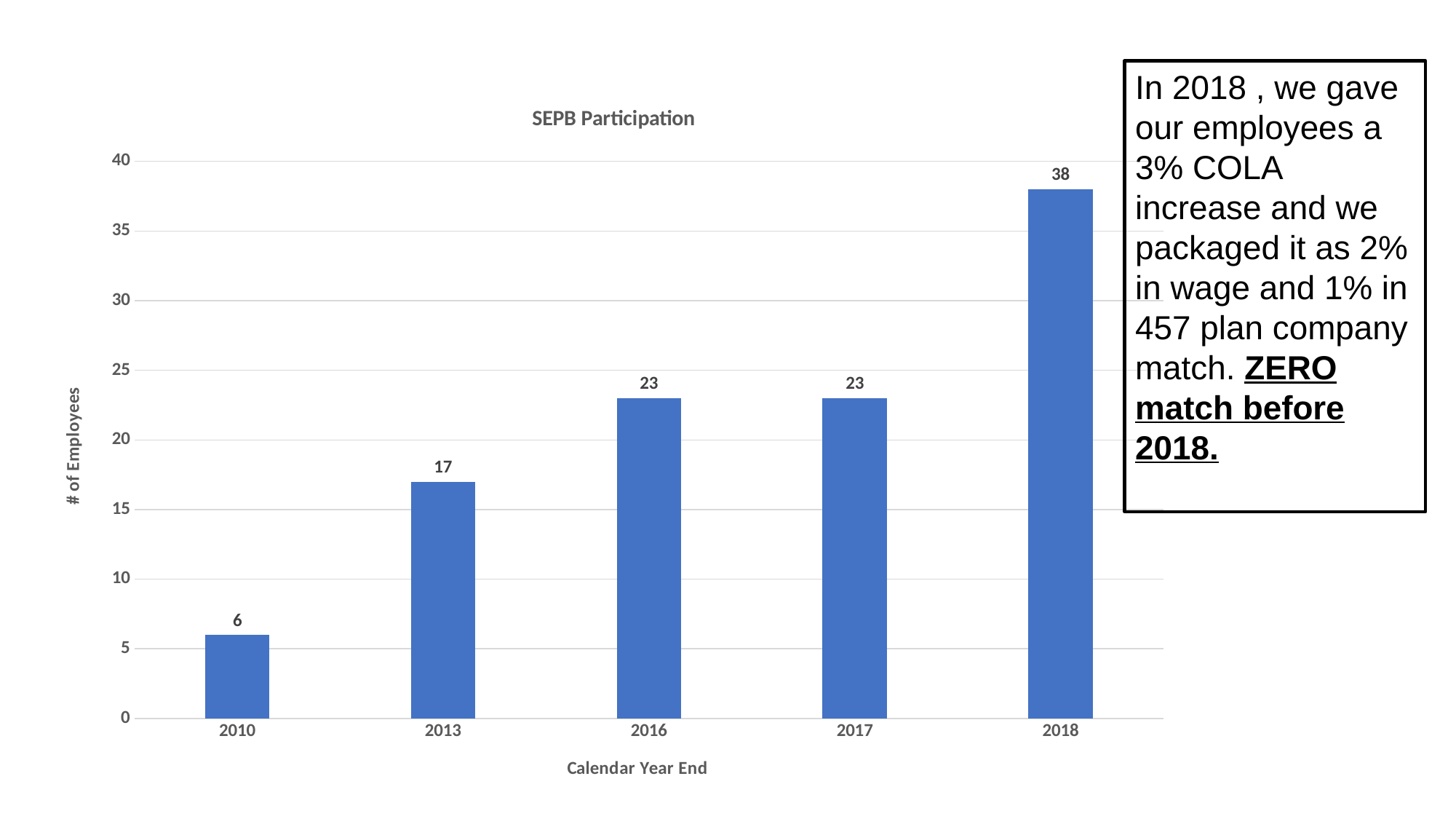
What is the number of employees for 2018? 38 What is the number of employees for 2013? 17 What kind of chart is shown on the slide? Bar chart What is the difference in number of employees between 2013 and 2010? 11 What is the number of employees for 2010? 6 What is the difference in number of employees between 2018 and 2017? 15 Which year has more employees, 2013 or 2016? 2016 Which year has the highest number of employees? 2018 What is the title of the chart? SEPB Participation Is the value for 2018 greater or less than 35? greater How many years are shown on the x axis? 5 Which year has the lowest number of employees? 2010